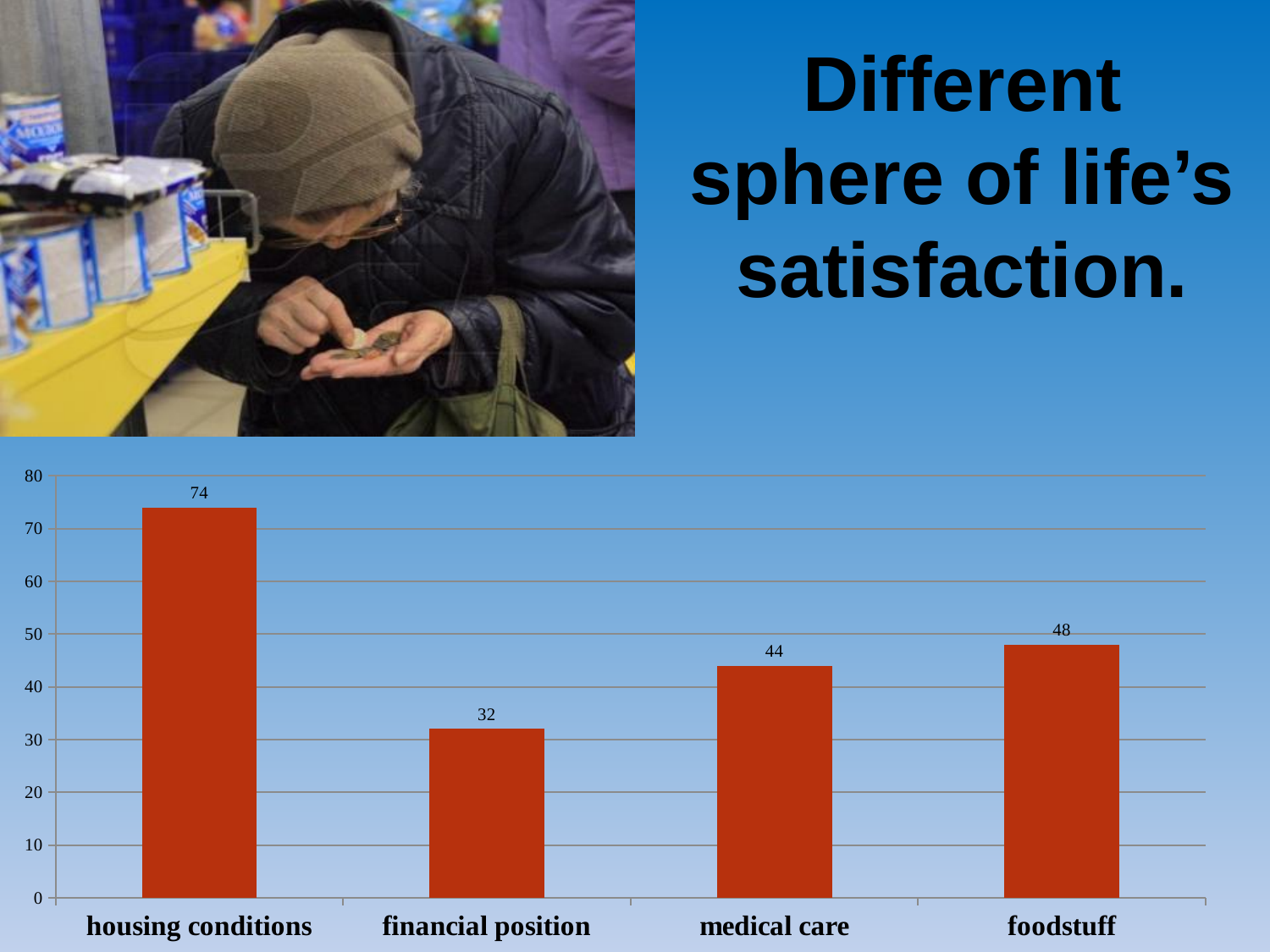
Which category has the lowest value? financial position What is the value for medical care? 44 What kind of chart is shown on the slide? bar chart Which category has the highest value? housing conditions What is the value for foodstuff? 48 Is the value for medical care greater or less than 40? greater What is the difference between the values for foodstuff and medical care? 4 Which is larger, the value for medical care or the value for foodstuff? foodstuff What is the value for housing conditions? 74 What is the difference between the values for housing conditions and financial position? 42 What is the value for financial position? 32 How many categories are shown in the chart? 4